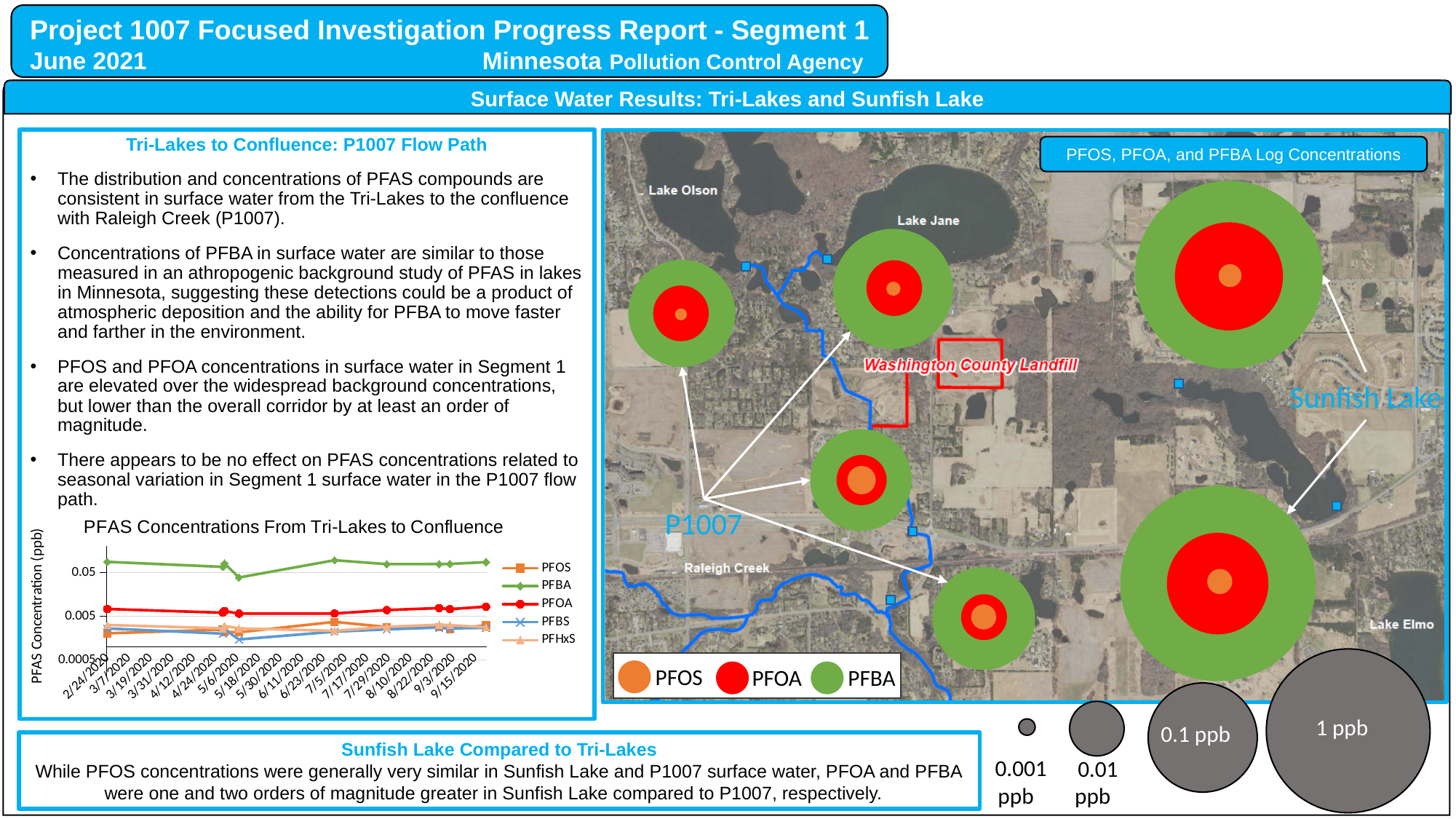
How many series does the legend of the 'PFAS Concentrations From Tri-Lakes to Confluence' chart list? 5 What kind of chart is 'PFAS Concentrations From Tri-Lakes to Confluence'? line chart How many date labels are shown on the x axis of the 'PFAS Concentrations From Tri-Lakes to Confluence' chart? 18 What is the y-axis label of the 'PFAS Concentrations From Tri-Lakes to Confluence' chart? PFAS Concentration (ppb) Which series has the highest concentrations throughout the 'PFAS Concentrations From Tri-Lakes to Confluence' chart? PFBA In the 'PFAS Concentrations From Tri-Lakes to Confluence' chart, is the PFOS value on 2/24/2020 greater or less than 0.005? less Which series is drawn in green in the 'PFAS Concentrations From Tri-Lakes to Confluence' chart? PFBA